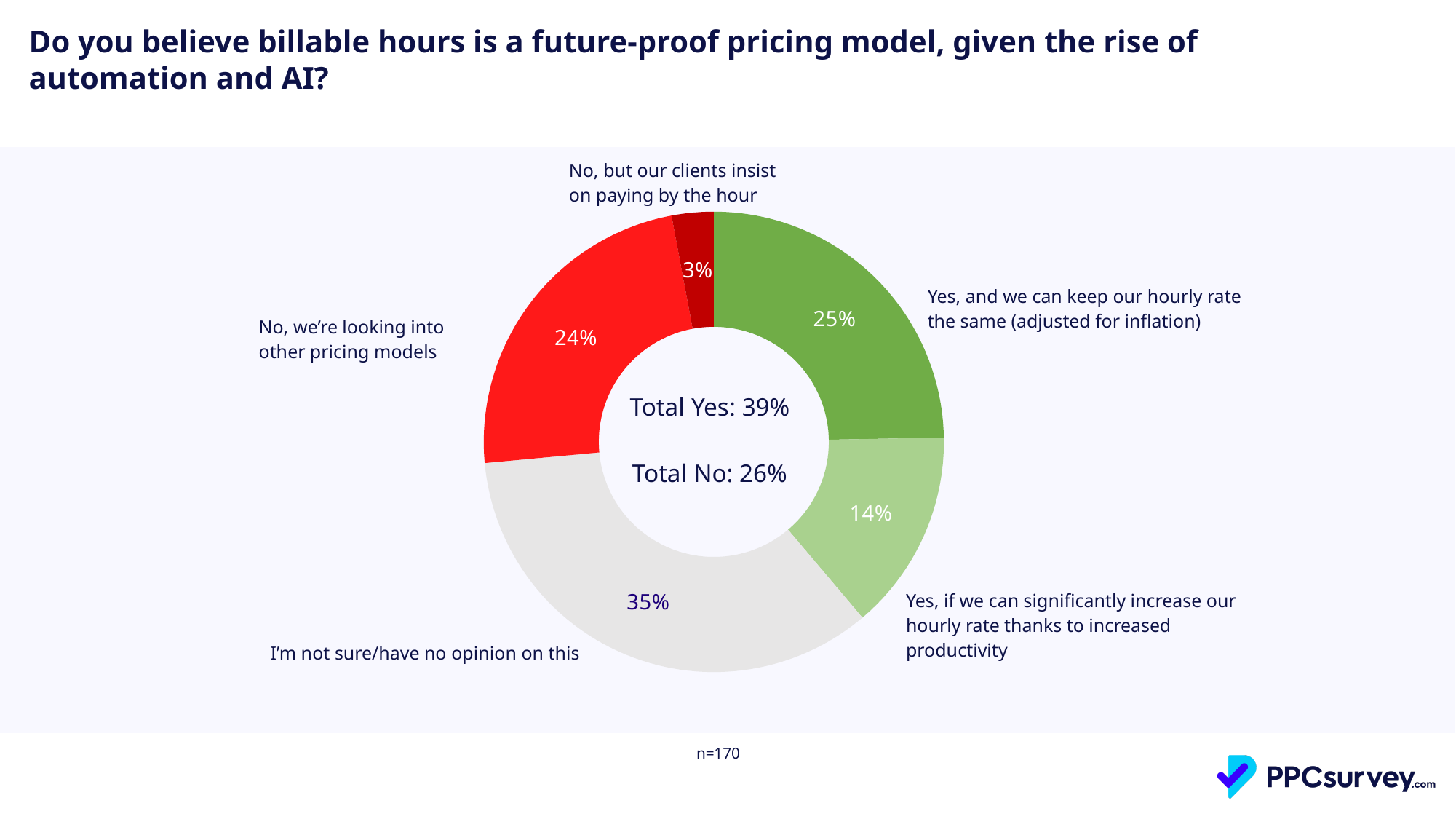
Which response has the smallest share of the pie? No, but our clients insist on paying by the hour What kind of chart is shown on the slide? Pie chart (donut) What percentage of respondents answered "I'm not sure/have no opinion on this"? 35% What percentage answered "Yes, and we can keep our hourly rate the same (adjusted for inflation)"? 25% How many response categories are shown in the pie chart? 5 What percentage answered "No, we're looking into other pricing models"? 24% What is the difference in percentage points between "No, we're looking into other pricing models" and "Yes, if we can significantly increase our hourly rate thanks to increased productivity"? 10 percentage points Which is larger: the share for "Yes, and we can keep our hourly rate the same" or the share for "No, we're looking into other pricing models"? Yes, and we can keep our hourly rate the same What is the sample size (n) stated on the slide? n=170 What percentage answered "No, but our clients insist on paying by the hour"? 3% Which response has the largest share of the pie? I'm not sure/have no opinion on this What is the Total Yes percentage shown in the centre of the chart? 39%